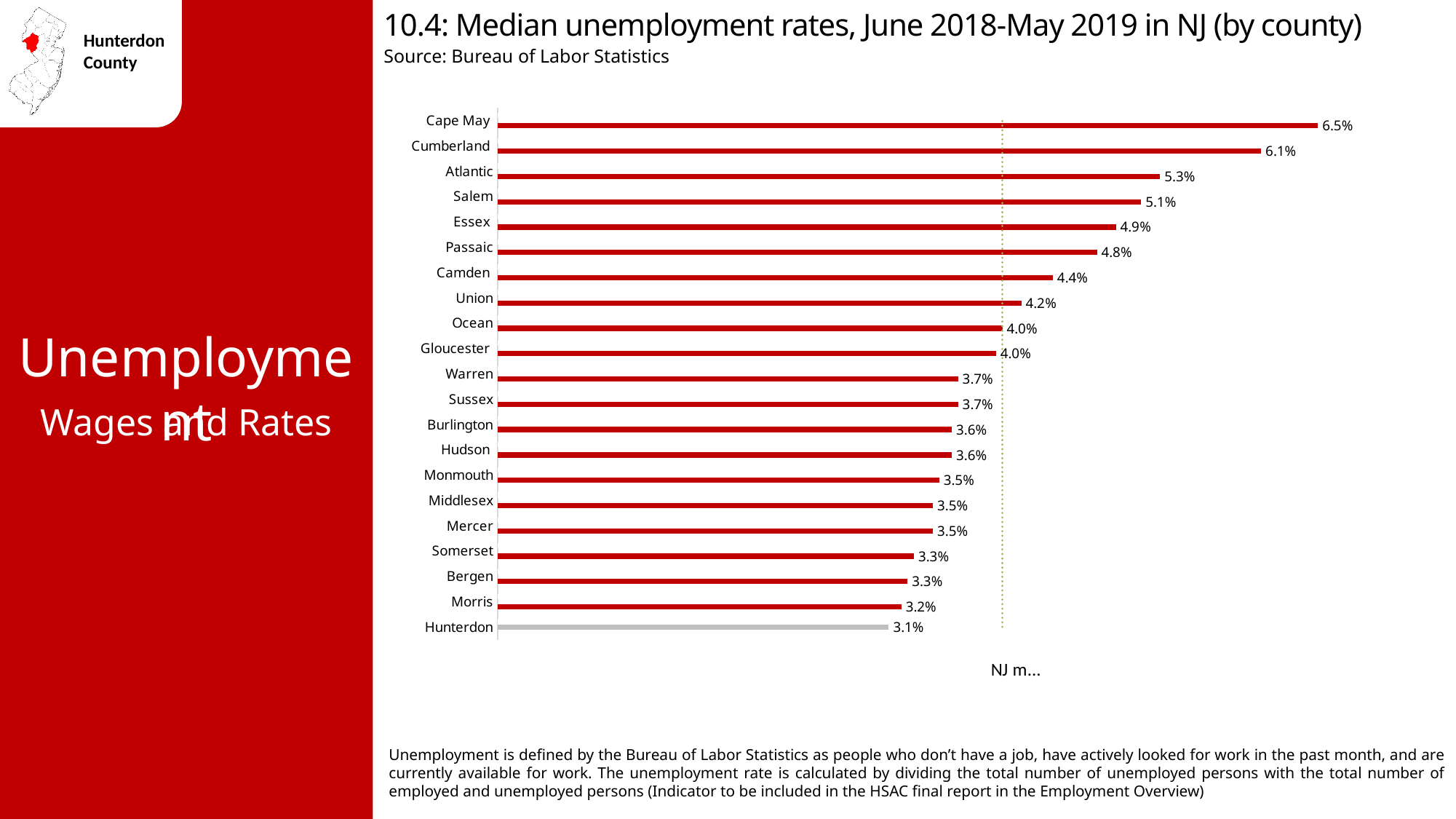
Which county's bar is shown in a different colour (grey) from the others? Hunterdon How many counties are shown in the chart? 21 What is the median unemployment rate for Cape May? 6.5% Which county has a higher median unemployment rate, Essex or Union? Essex What is the difference between the median unemployment rates of Cape May and Hunterdon? 3.4% What is the median unemployment rate for Morris? 3.2% What is the median unemployment rate for Hunterdon? 3.1% Which county has the highest median unemployment rate? Cape May What is the difference between the median unemployment rates of Cumberland and Atlantic? 0.8% What type of chart is used to show the median unemployment rates? Bar chart What is the median unemployment rate for Camden? 4.4% Which county has the lowest median unemployment rate? Hunterdon